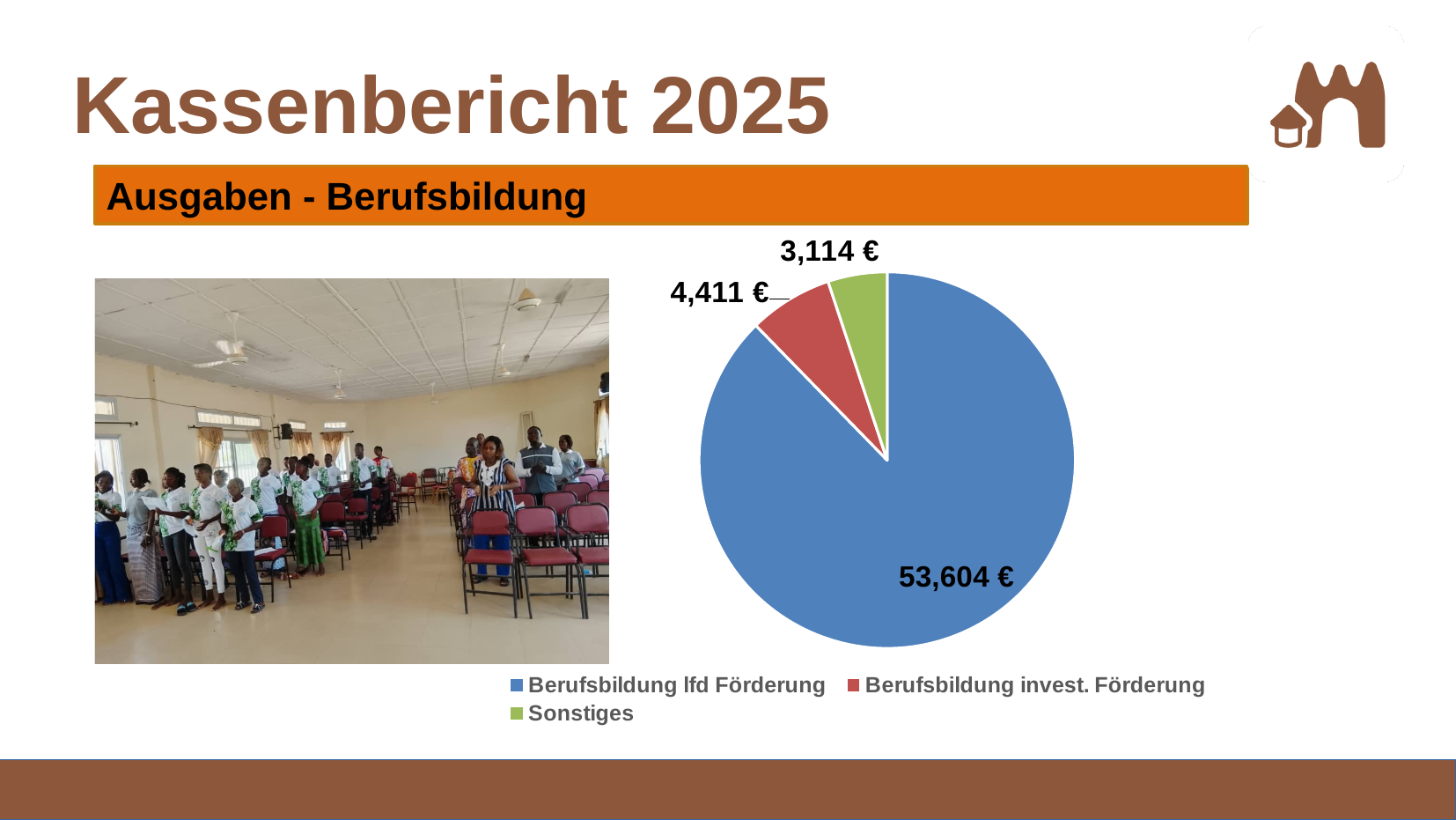
Which category has the smallest slice of the pie? Sonstiges What colour is the slice for Sonstiges? Green Which is larger, Berufsbildung invest. Förderung or Sonstiges? Berufsbildung invest. Förderung What is the value for Berufsbildung lfd Förderung? 53,604 € What kind of chart is shown on the slide? Pie chart How many categories does the pie chart show? 3 Which category has the largest slice of the pie? Berufsbildung lfd Förderung What is the value for Berufsbildung invest. Förderung? 4,411 € What is the difference between Berufsbildung invest. Förderung and Sonstiges? 1,297 € What is the value for Sonstiges? 3,114 € What is the difference between Berufsbildung lfd Förderung and Berufsbildung invest. Förderung? 49,193 € What is the total of all slices in the pie chart? 61,129 €